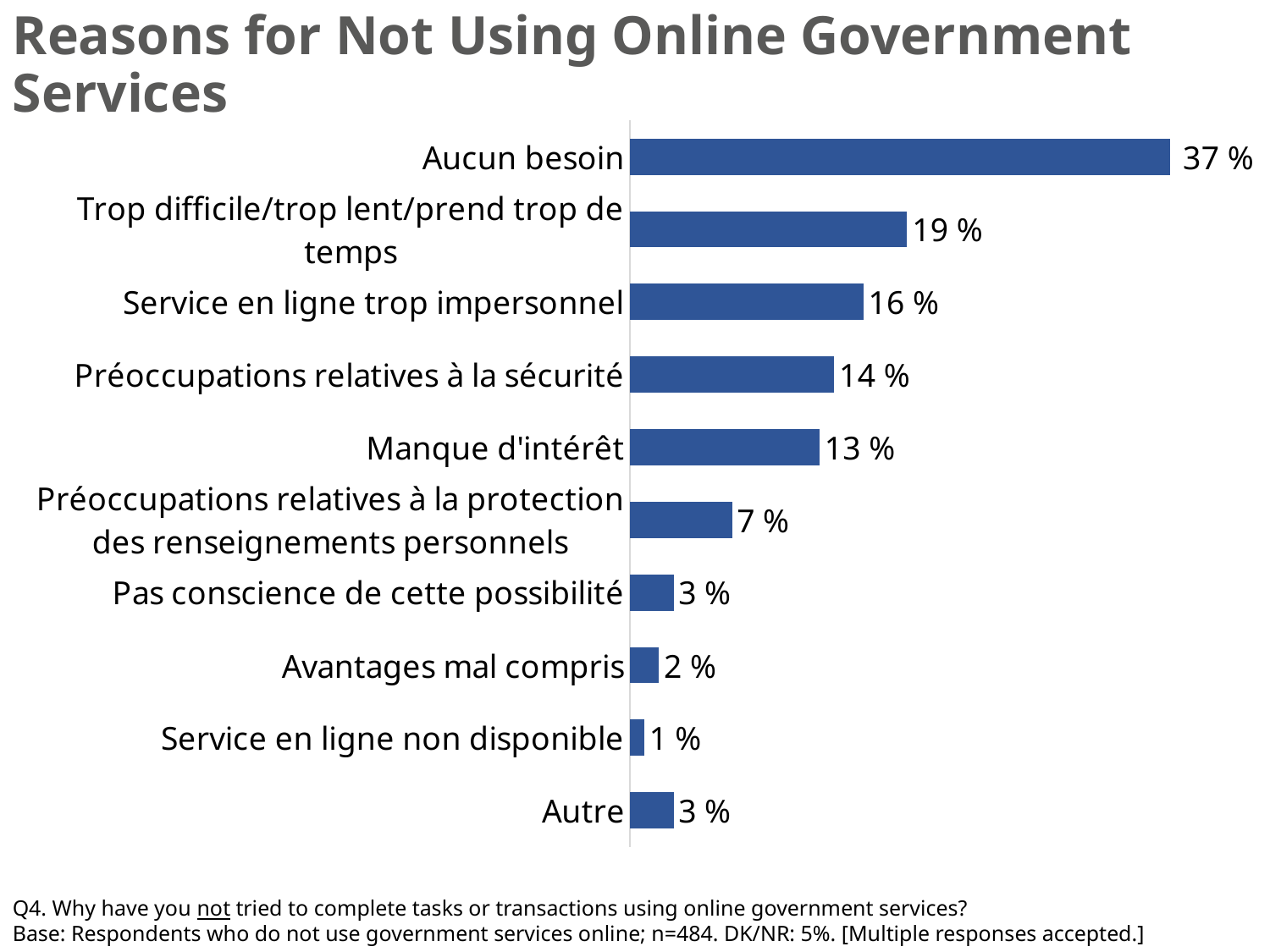
What is the difference between the values for "Aucun besoin" and "Trop difficile/trop lent/prend trop de temps"? 18 % What is the value for "Préoccupations relatives à la sécurité"? 14 % What is the title of the slide? Reasons for Not Using Online Government Services What is the difference between the values for "Service en ligne trop impersonnel" and "Manque d'intérêt"? 3 % What kind of chart is shown on the slide? Bar chart How many categories are shown in the chart? 10 Which category has the lowest value? Service en ligne non disponible Which category has the highest value? Aucun besoin Which is larger, the value for "Manque d'intérêt" or the value for "Préoccupations relatives à la protection des renseignements personnels"? Manque d'intérêt What is the sample size (n) stated in the base note below the chart? 484 What is the value for "Aucun besoin"? 37 % What is the value for "Préoccupations relatives à la protection des renseignements personnels"? 7 %